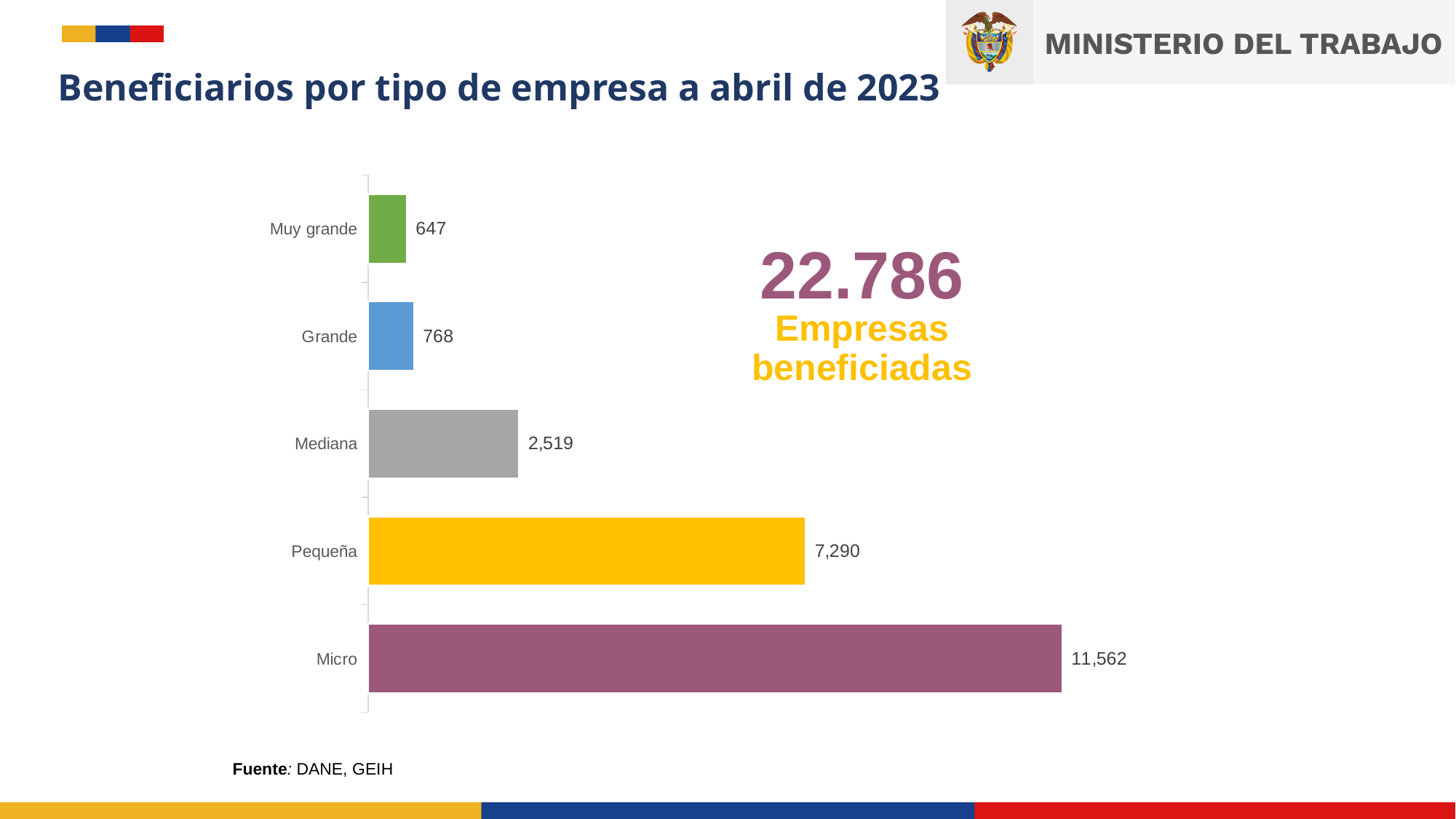
How many company types are shown in the chart? 5 What is the value for Micro? 11,562 What is the difference between the values for Grande and Muy grande? 121 What is the value for Grande? 768 What is the difference between the values for Micro and Pequeña? 4,272 What is the value for Muy grande? 647 What is the value for Mediana? 2,519 Which company type has the highest value? Micro What kind of chart is shown on the slide? Bar chart Which company type has the lowest value? Muy grande Which is larger, the value for Mediana or the value for Grande? Mediana What is the value for Pequeña? 7,290